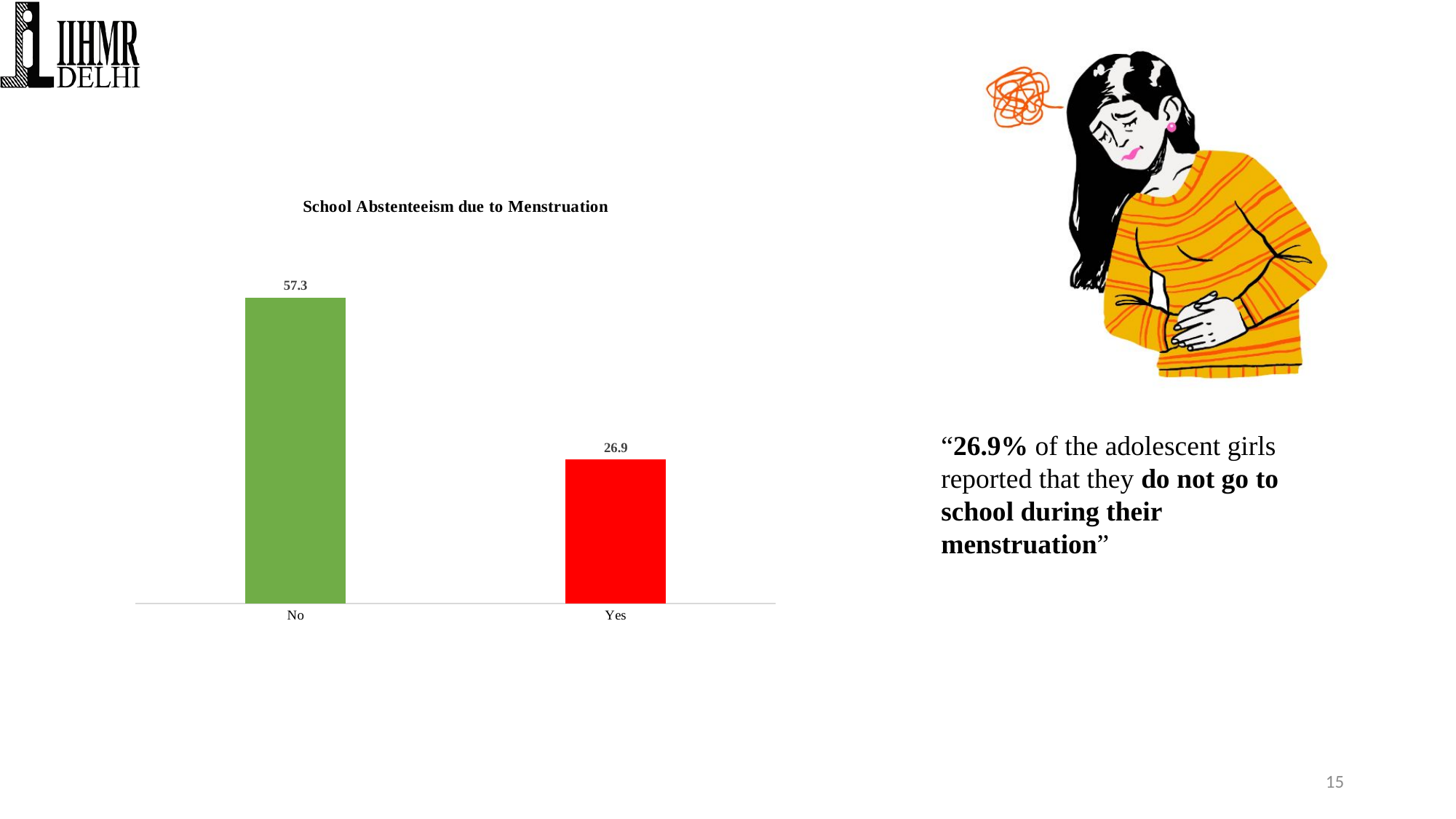
What is the value for "Yes" in the School Abstenteeism due to Menstruation chart? 26.9 What is the value for "No" in the School Abstenteeism due to Menstruation chart? 57.3 What is the difference between the values for "No" and "Yes"? 30.4 Which is larger, the value for "No" or the value for "Yes"? No What kind of chart is shown on the slide? Bar chart Do the values rise or fall from "No" to "Yes" along the x axis? Fall What colour is the bar for "Yes"? Red What is the title of the chart? School Abstenteeism due to Menstruation How many categories are shown in the chart? 2 Which category has the highest value in the chart? No Which category has the lowest value in the chart? Yes